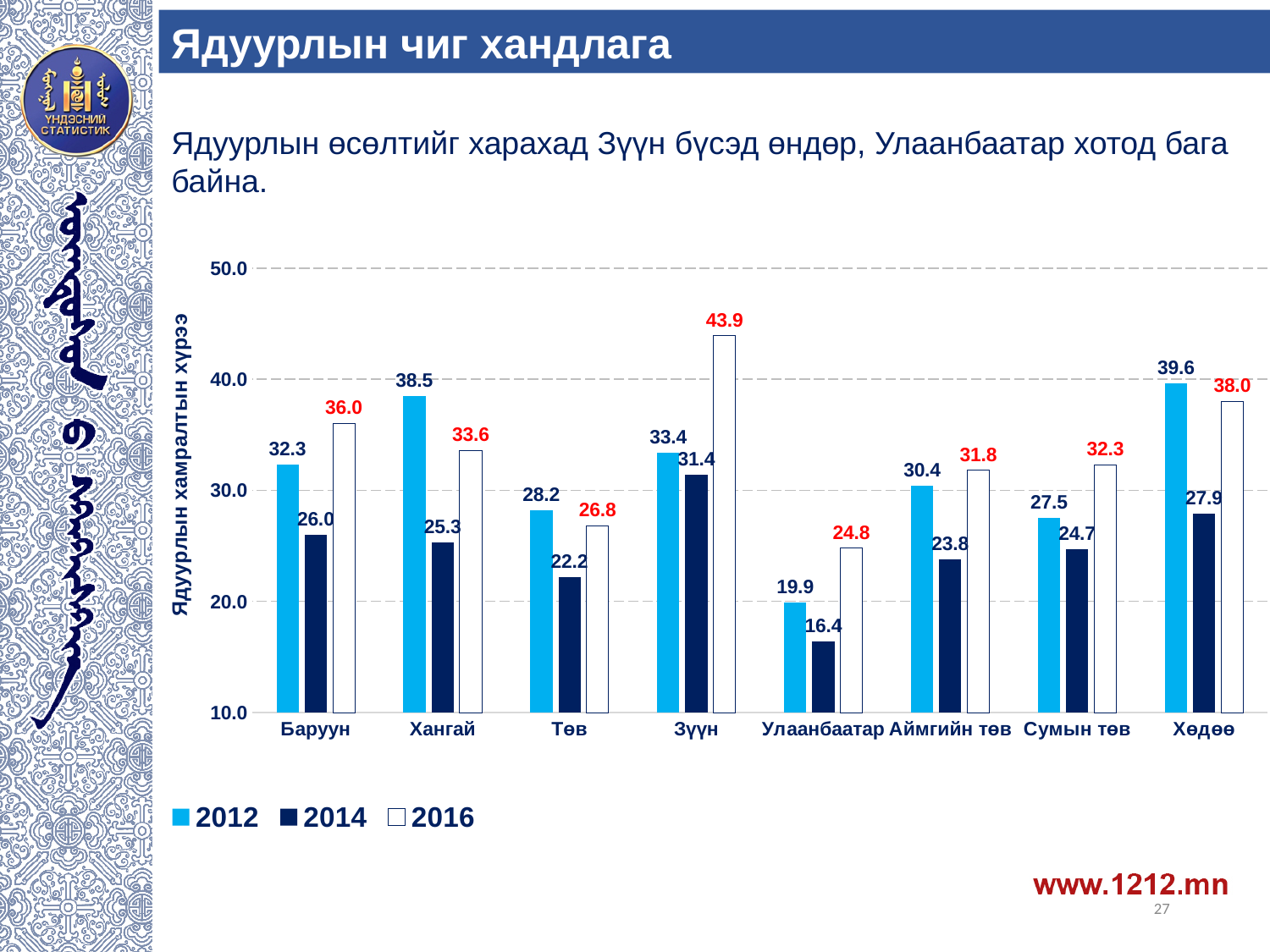
Is the 2016 value for Улаанбаатар greater or less than 30.0? less Which category has the lowest value in the 2014 series? Улаанбаатар What is the value for Улаанбаатар in the 2014 series? 16.4 How many series does the legend list? 3 What kind of chart is shown on the slide? bar chart What is the y-axis title of the chart? Ядуурлын хамралтын хүрээ What is the value for Зүүн in the 2016 series? 43.9 What is the value for Хөдөө in the 2012 series? 39.6 Which category has the highest value in the 2016 series? Зүүн What is the difference between the 2016 and 2012 values for Зүүн? 10.5 Which is larger for Хангай: the 2012 value or the 2016 value? 2012 How many categories are shown on the x axis? 8